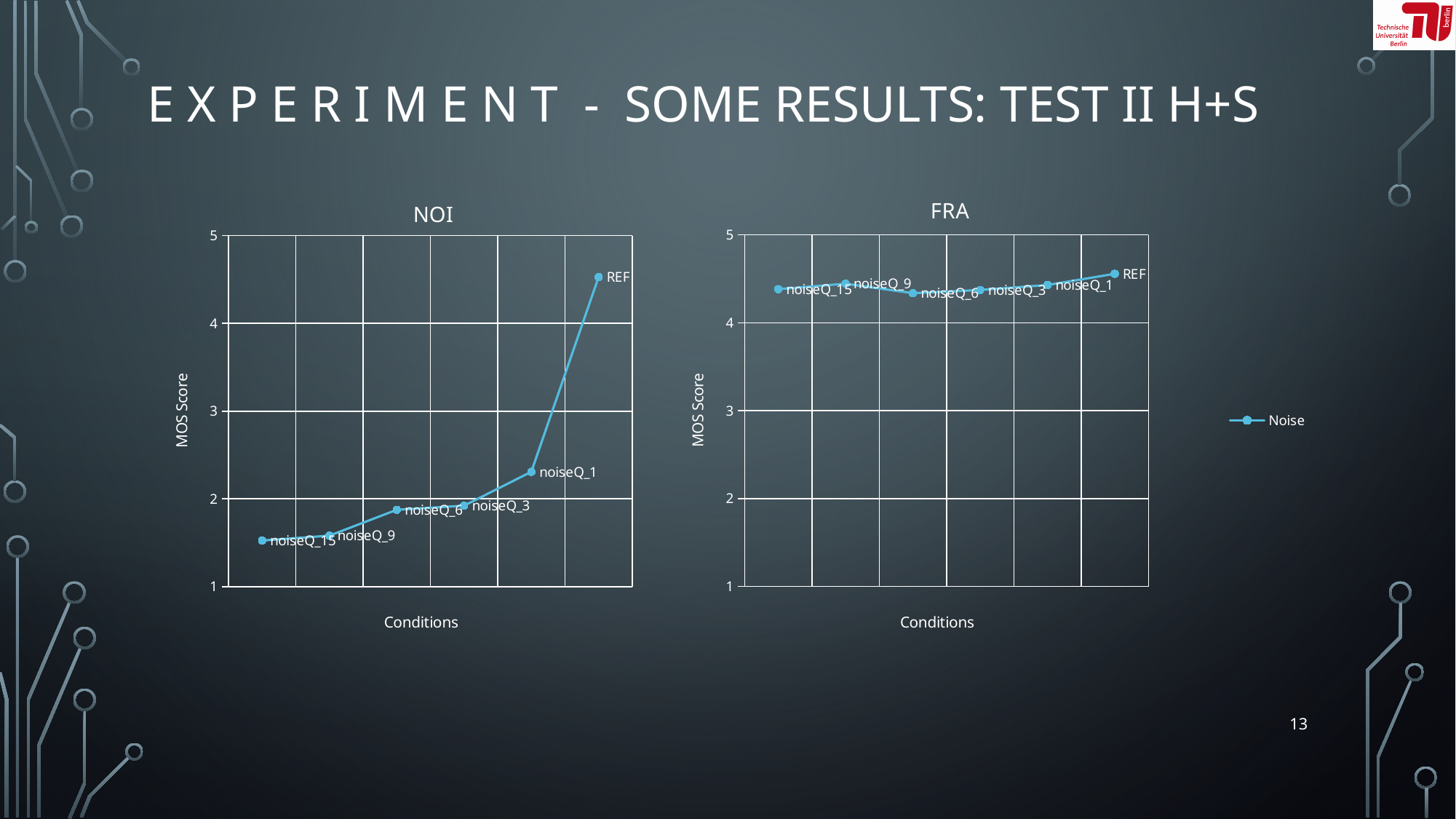
In the NOI chart, is the value for REF greater or less than 4? greater What is the y-axis title of the FRA chart? MOS Score In the FRA chart, is the value for noiseQ_6 greater or less than 4? greater How many data points are plotted in the NOI chart? 6 What kind of chart is the NOI chart? line chart In the NOI chart, is the value for noiseQ_1 greater or less than 2? greater What series name is shown in the legend? Noise In the NOI chart, which condition has the highest MOS Score? REF In the NOI chart, which is larger, the value for REF or the value for noiseQ_1? REF In the NOI chart, do the values rise or fall from noiseQ_15 to REF? rise How many series does the legend list? 1